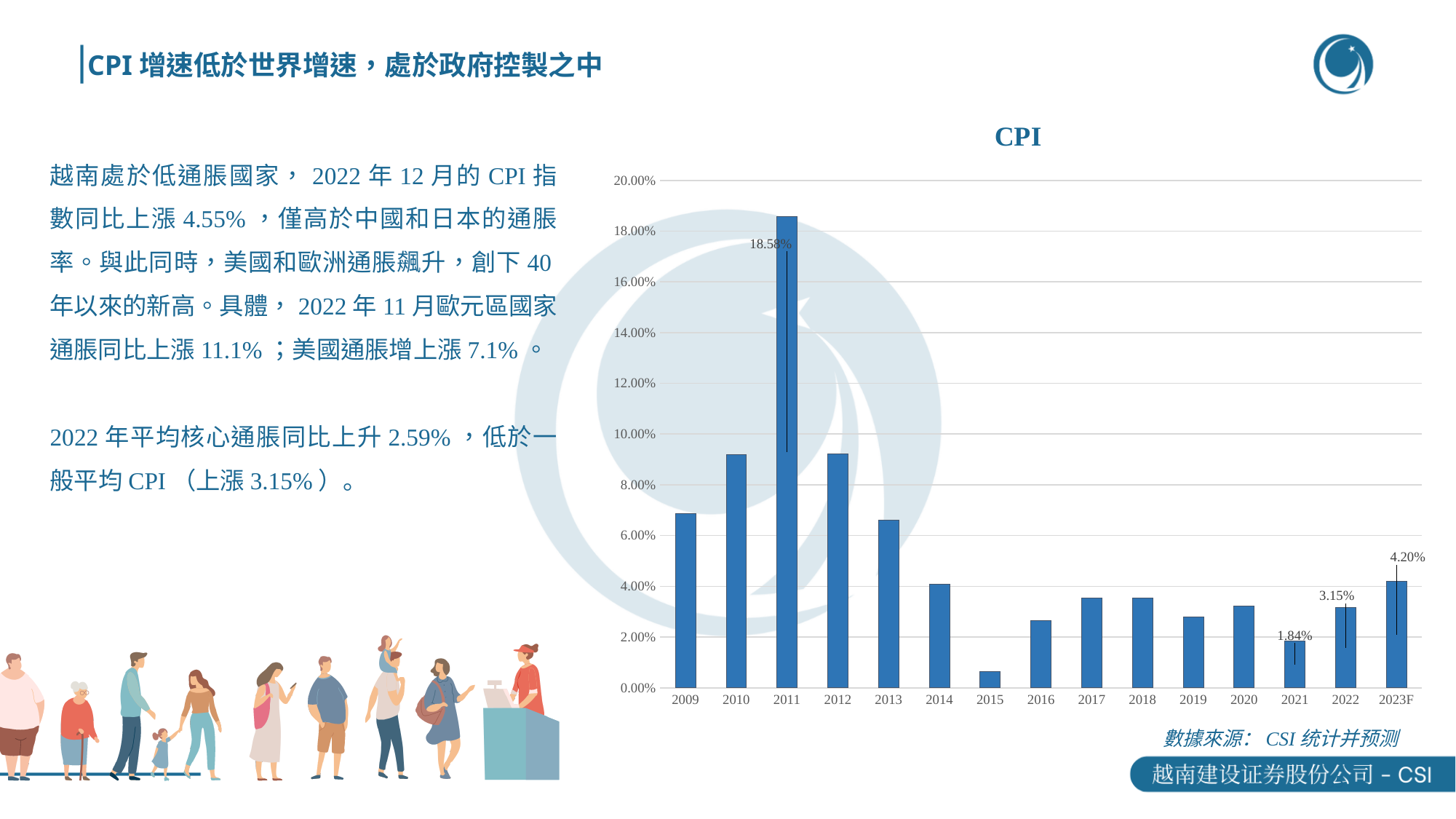
What is the CPI value for 2011? 18.58% Which year has the highest CPI value? 2011 What is the title of the chart? CPI What is the CPI value for 2021? 1.84% What is the difference between the CPI values for 2022 and 2021? 1.31% What is the CPI value for 2023F? 4.20% What is the CPI value for 2022? 3.15% Is the CPI value for 2009 greater or less than 6.00%? greater How many years are shown on the x axis of the chart? 15 What kind of chart is shown on the slide? bar chart Is the CPI value for 2010 or 2013 larger? 2010 Which year has the lowest CPI value? 2015